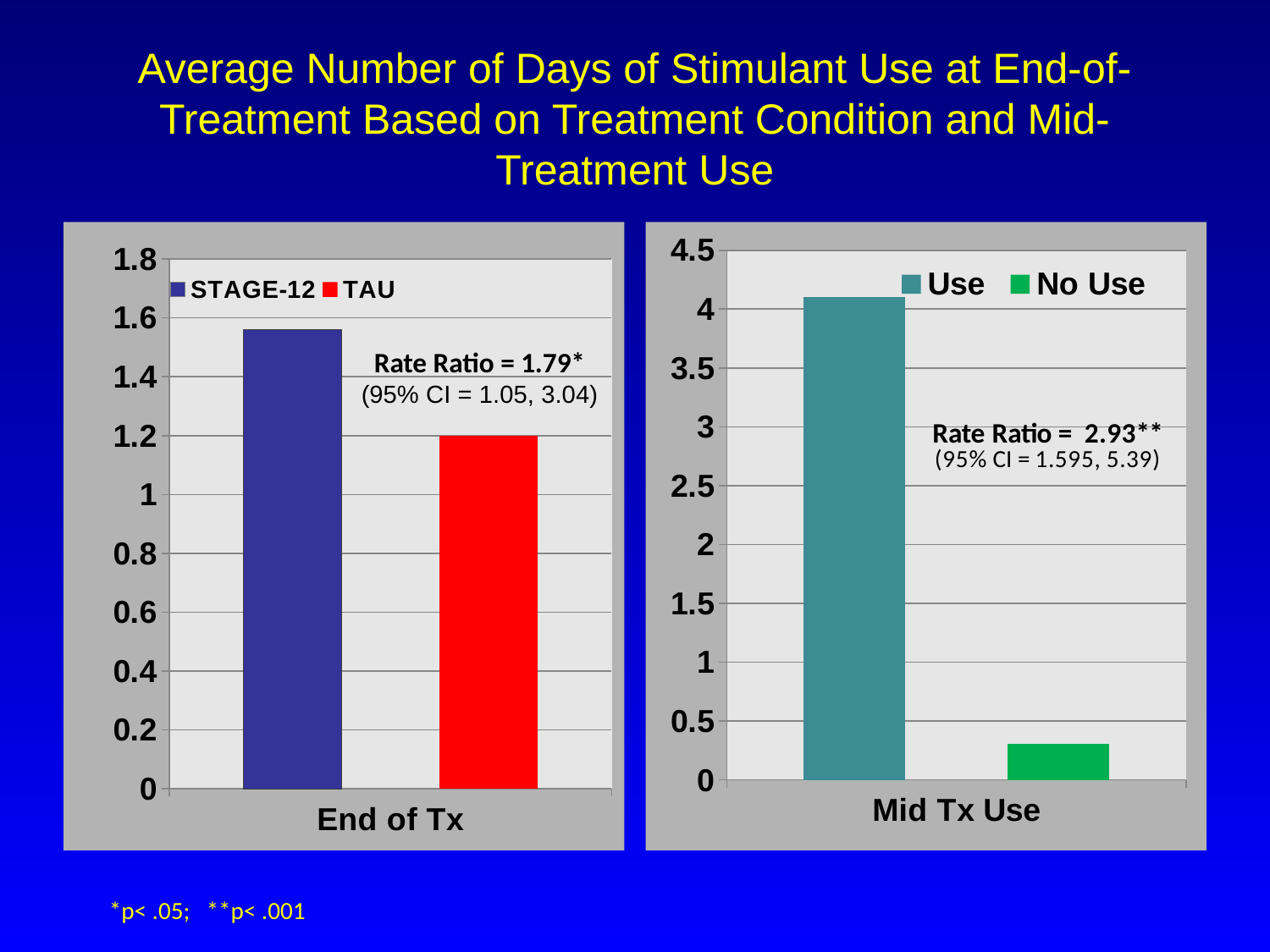
What kind of chart is the left chart, titled "End of Tx"? bar chart In the right chart (Mid Tx Use), is the value for No Use greater or less than 1? less In the left chart (End of Tx), how many series does the legend list? 2 In the right chart (Mid Tx Use), how many series does the legend list? 2 In the right chart (Mid Tx Use), what rate ratio is printed on the chart? 2.93 In the right chart (Mid Tx Use), is the value for Use greater or less than 3.5? greater In the right chart (Mid Tx Use), which bar is taller, Use or No Use? Use In the left chart (End of Tx), which bar is taller, STAGE-12 or TAU? STAGE-12 In the left chart (End of Tx), is the value for STAGE-12 greater or less than 1.4? greater In the left chart (End of Tx), which series has the lowest value? TAU In the left chart (End of Tx), what are the two legend entries? STAGE-12 and TAU